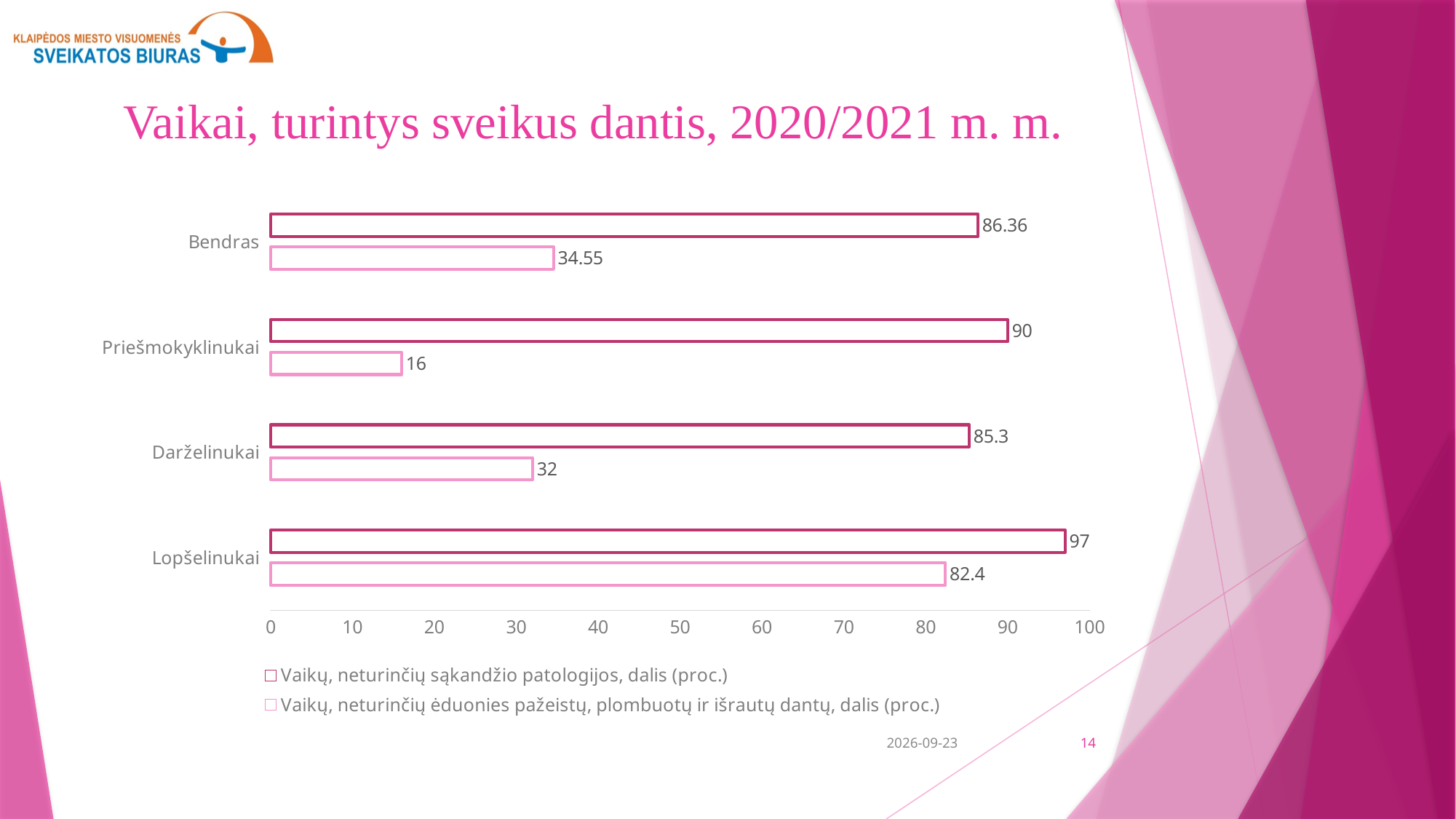
What is the difference between the two series values for Darželinukai? 53.3 What kind of chart is shown on the slide? bar chart Which category has the highest value in the series 'Vaikų, neturinčių ėduonies pažeistų, plombuotų ir išrautų dantų, dalis (proc.)'? Lopšelinukai Which category has the lowest value in the series 'Vaikų, neturinčių sąkandžio patologijos, dalis (proc.)'? Darželinukai How many categories are shown on the chart? 4 How many series does the legend list? 2 Which is larger: the 'Vaikų, neturinčių ėduonies pažeistų, plombuotų ir išrautų dantų, dalis (proc.)' value for Bendras or for Darželinukai? Bendras What is the value for Priešmokyklinukai in the series 'Vaikų, neturinčių ėduonies pažeistų, plombuotų ir išrautų dantų, dalis (proc.)'? 16 What is the title of the slide? Vaikai, turintys sveikus dantis, 2020/2021 m. m. Is the value for Lopšelinukai in the series 'Vaikų, neturinčių ėduonies pažeistų, plombuotų ir išrautų dantų, dalis (proc.)' greater or less than 80? greater What is the value for Bendras in the series 'Vaikų, neturinčių sąkandžio patologijos, dalis (proc.)'? 86.36 What is the value for Lopšelinukai in the series 'Vaikų, neturinčių sąkandžio patologijos, dalis (proc.)'? 97